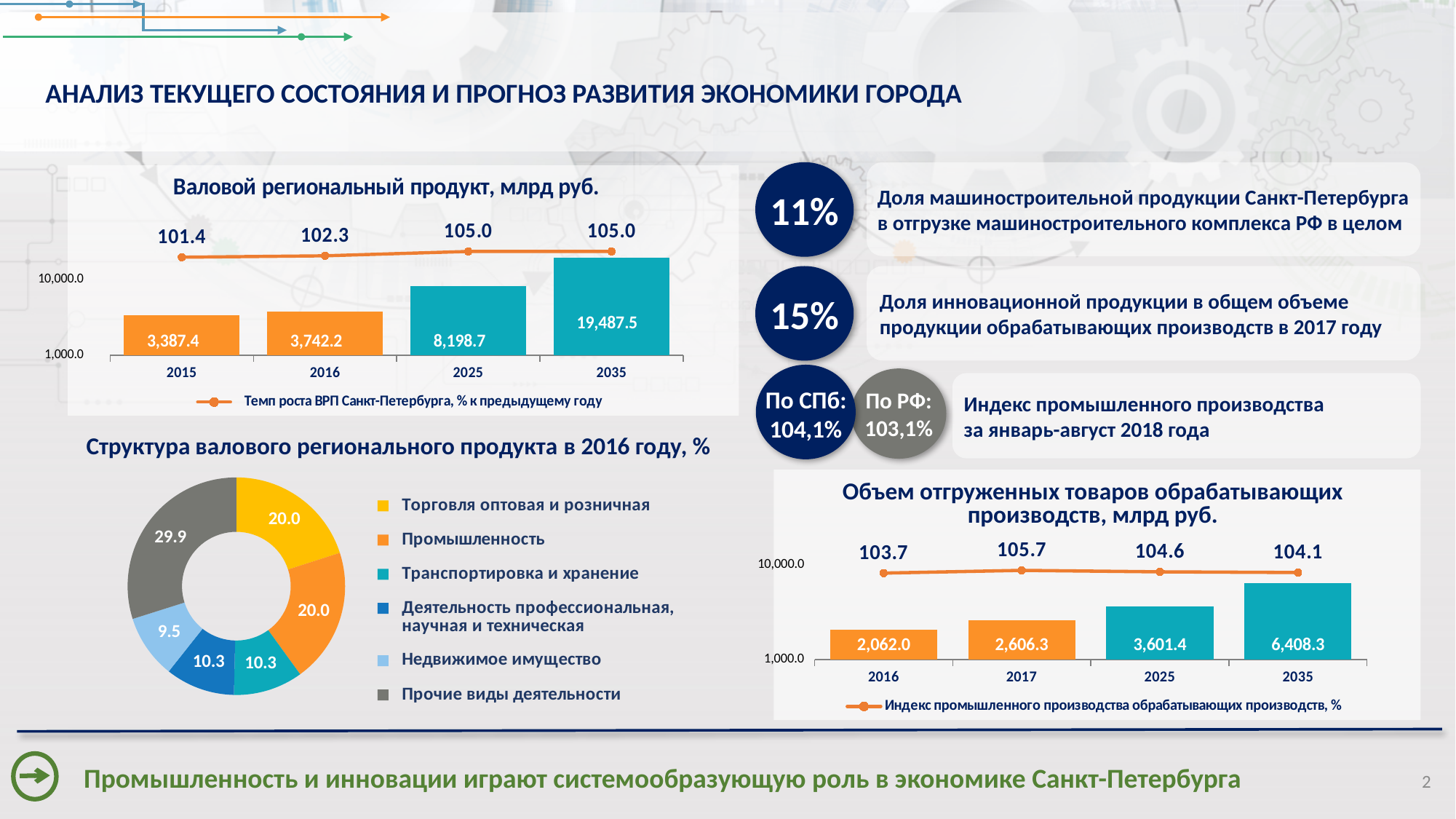
In the chart 'Объем отгруженных товаров обрабатывающих производств, млрд руб.', what is the difference between the bar values for 2035 and 2016? 4,346.3 In the doughnut chart 'Структура валового регионального продукта в 2016 году, %', what is the value for 'Промышленность'? 20.0 In the chart 'Валовой региональный продукт, млрд руб.', do the bar values rise or fall from 2015 to 2035? rise In the chart 'Валовой региональный продукт, млрд руб.', what is the value of the bar for 2035? 19,487.5 In the chart 'Валовой региональный продукт, млрд руб.', what is the difference between the bar values for 2016 and 2015? 354.8 In the doughnut chart 'Структура валового регионального продукта в 2016 году, %', how many categories does the legend list? 6 In the chart 'Валовой региональный продукт, млрд руб.', what is the value of the line 'Темп роста ВРП Санкт-Петербурга' for 2016? 102.3 In the doughnut chart 'Структура валового регионального продукта в 2016 году, %', which category has the smallest share? Недвижимое имущество In the chart 'Объем отгруженных товаров обрабатывающих производств, млрд руб.', what is the value of the bar for 2025? 3,601.4 In the doughnut chart 'Структура валового регионального продукта в 2016 году, %', which category has the largest share? Прочие виды деятельности In the chart 'Валовой региональный продукт, млрд руб.', how many years are shown on the x axis? 4 In the chart 'Объем отгруженных товаров обрабатывающих производств, млрд руб.', in which year is the line 'Индекс промышленного производства обрабатывающих производств, %' highest? 2017